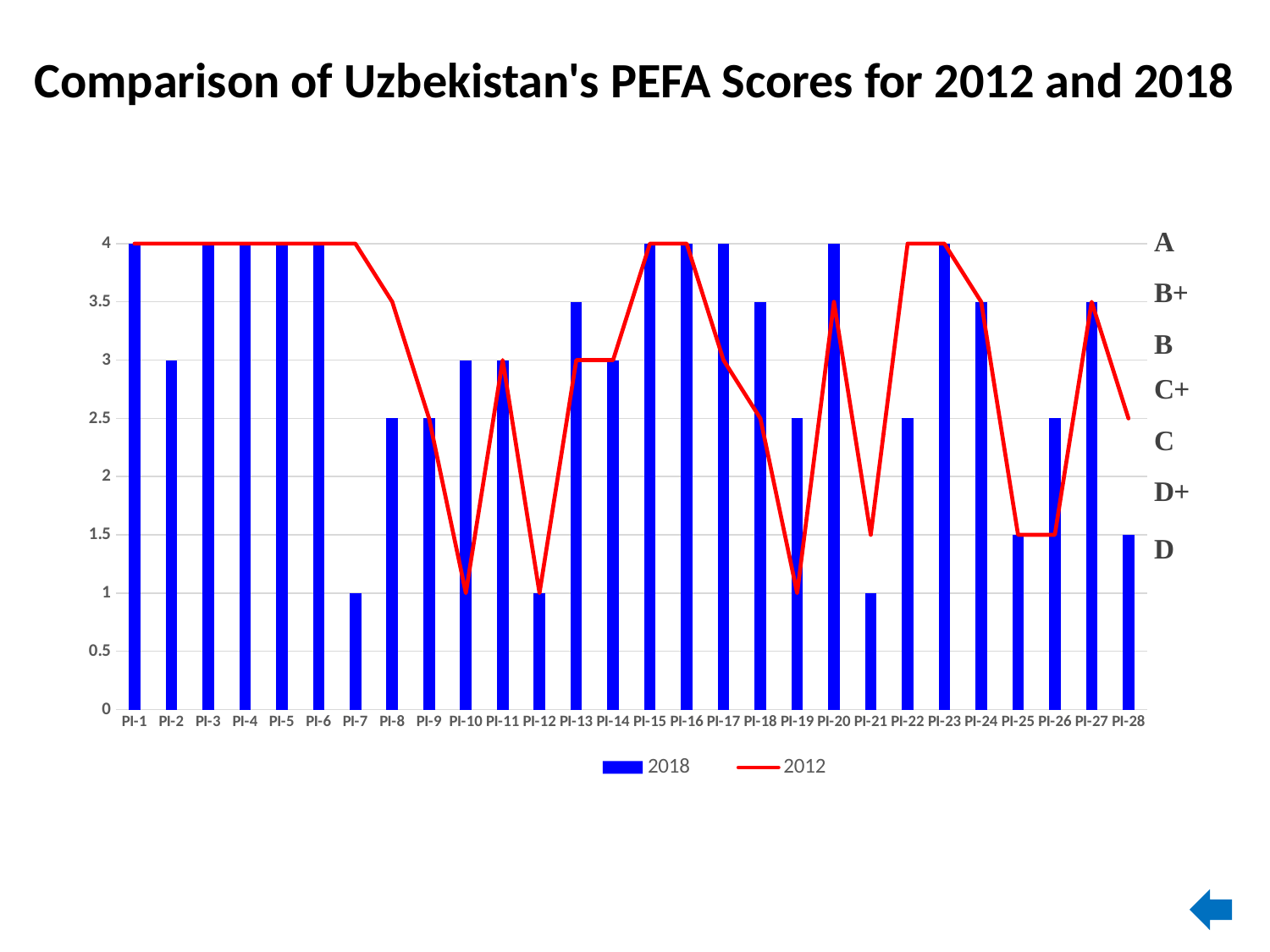
Which series is drawn as a red line? 2012 How many performance indicators (categories) are shown on the x axis? 28 Is the 2018 value for PI-13 greater or less than 3? greater Which is larger for PI-22, the 2018 value or the 2012 value? 2012 What is the 2012 value for PI-28? 2.5 Is the 2012 value for PI-19 greater or less than 2? less Which is larger for PI-10, the 2018 value or the 2012 value? 2018 What kind of chart is this? Combination bar and line chart How many series does the legend list? 2 What is the 2018 value for PI-28? 1.5 What is the 2018 value for PI-7? 1 What is the 2018 value for PI-2? 3